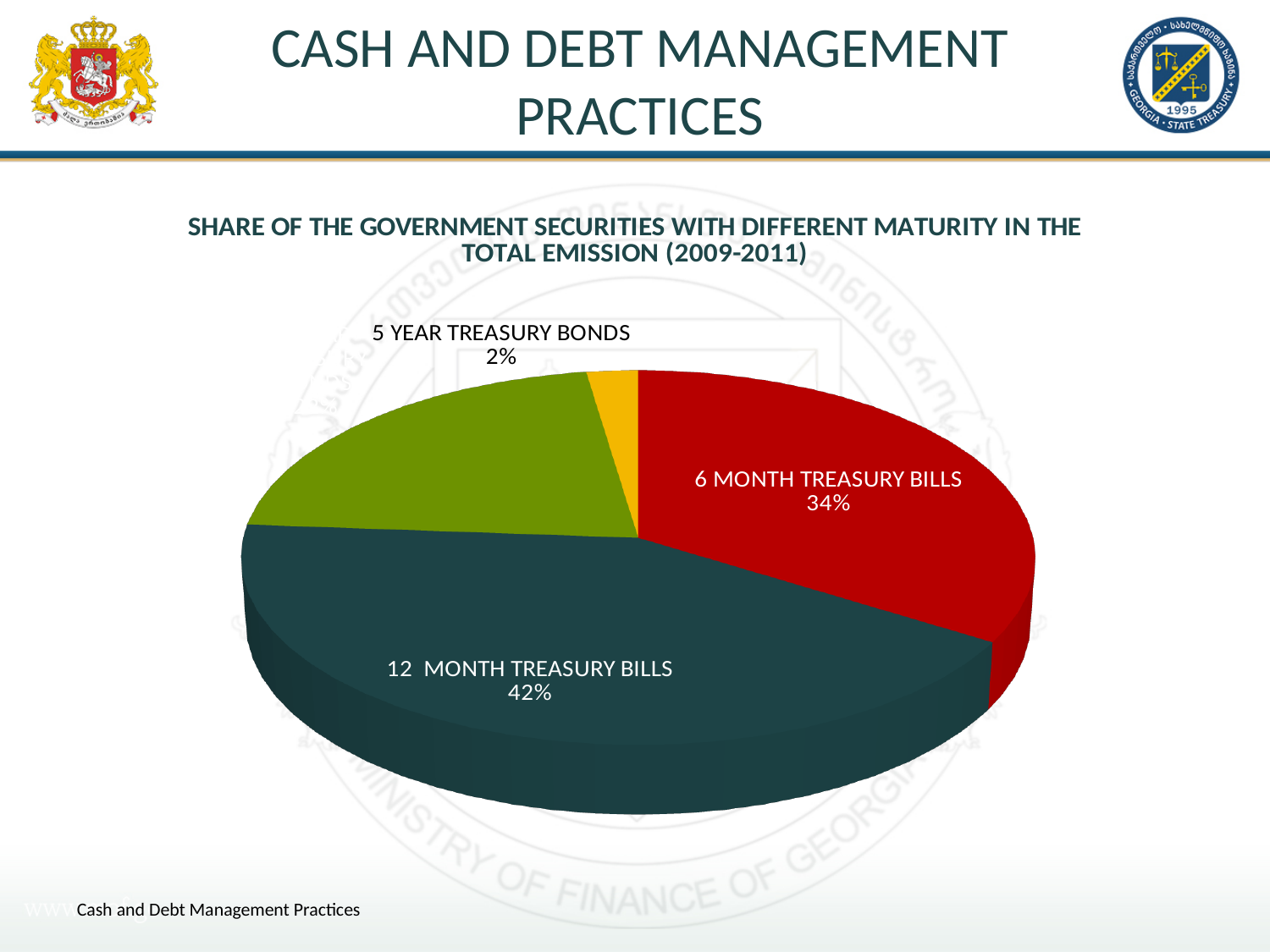
What share of the total emission do 5 year treasury bonds account for? 2% What share of the total emission do 6 month treasury bills account for? 34% What kind of chart is shown on the slide? Pie chart What share of the total emission do 12 month treasury bills account for? 42% What period does the chart title say the data covers? 2009-2011 How many percentage points larger is the share of 12 month treasury bills than the share of 6 month treasury bills? 8 Which security type has the largest share of the total emission? 12 month treasury bills What colour is the slice for 6 month treasury bills? Red Which has a larger share of the total emission, 6 month treasury bills or 12 month treasury bills? 12 month treasury bills How many slices does the pie chart have? 4 Which security type has the smallest share of the total emission? 5 year treasury bonds How many percentage points larger is the share of 6 month treasury bills than the share of 5 year treasury bonds? 32